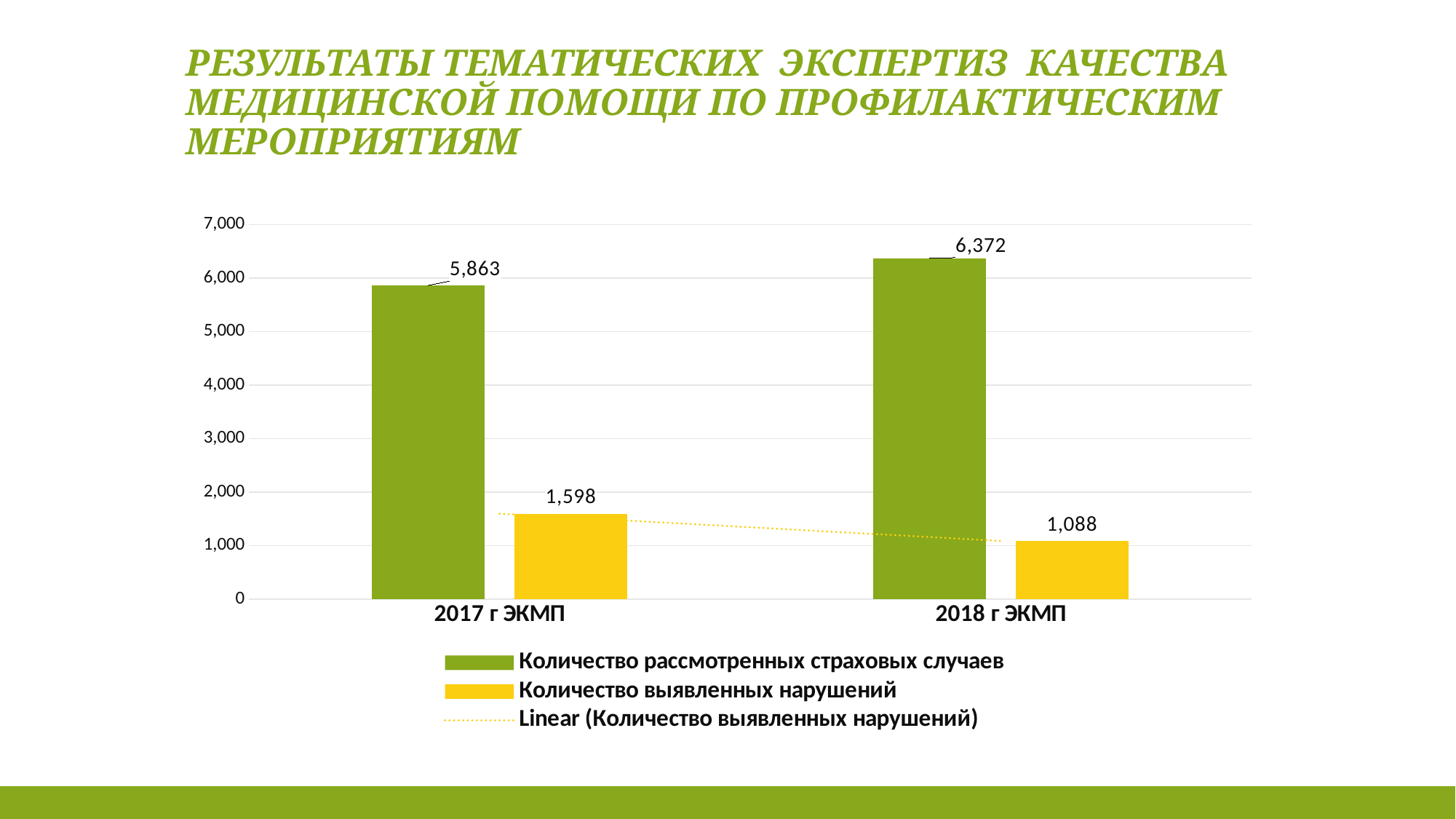
What kind of chart is shown on the slide? bar chart Does "Количество выявленных нарушений" rise or fall from 2017 г ЭКМП to 2018 г ЭКМП? fall What is the difference between "Количество рассмотренных страховых случаев" in 2018 г ЭКМП and 2017 г ЭКМП? 509 What is the value of "Количество рассмотренных страховых случаев" for 2017 г ЭКМП? 5,863 Which category has the higher value for "Количество рассмотренных страховых случаев"? 2018 г ЭКМП How many entries does the legend list? 3 Which category has the lowest value for "Количество выявленных нарушений"? 2018 г ЭКМП How many categories are shown on the x axis? 2 Is "Количество выявленных нарушений" for 2017 г ЭКМП greater or less than 2,000? less What is the value of "Количество выявленных нарушений" for 2018 г ЭКМП? 1,088 What is the difference between "Количество выявленных нарушений" in 2017 г ЭКМП and 2018 г ЭКМП? 510 What is the value of "Количество выявленных нарушений" for 2017 г ЭКМП? 1,598